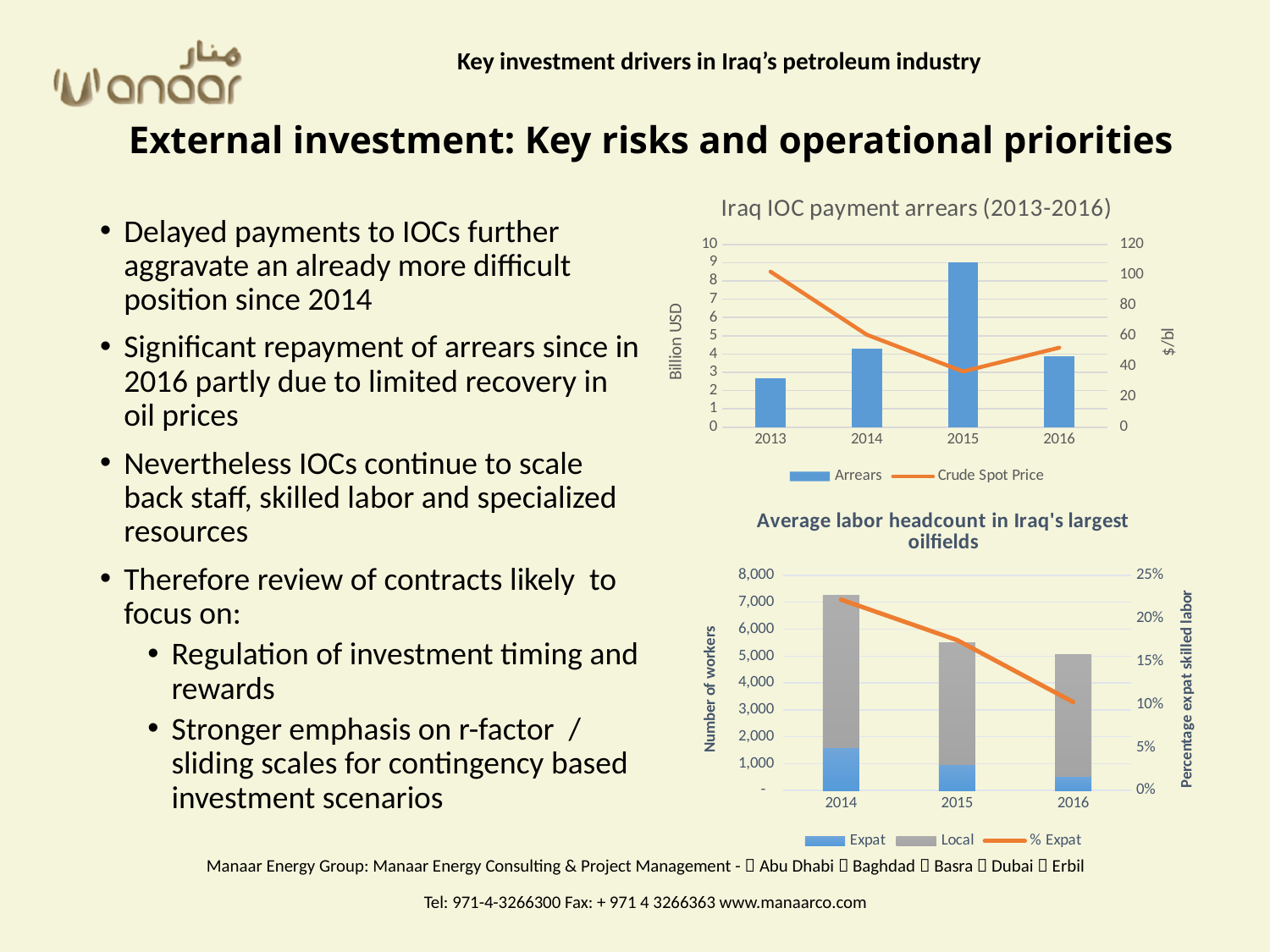
In the 'Iraq IOC payment arrears (2013-2016)' chart, is the crude spot price for 2013 greater or less than 80 $/bl? greater In the 'Iraq IOC payment arrears (2013-2016)' chart, how many years are shown on the x axis? 4 In the 'Average labor headcount in Iraq's largest oilfields' chart, which is larger, the Expat headcount in 2014 or in 2016? 2014 In the 'Average labor headcount in Iraq's largest oilfields' chart, what series does the grey colour represent? Local In the 'Iraq IOC payment arrears (2013-2016)' chart, which year has the lowest arrears bar? 2013 In the 'Average labor headcount in Iraq's largest oilfields' chart, which year has the highest total headcount? 2014 In the 'Average labor headcount in Iraq's largest oilfields' chart, is the % Expat value for 2014 greater or less than 20%? greater In the 'Iraq IOC payment arrears (2013-2016)' chart, which year has the highest arrears bar? 2015 In the 'Iraq IOC payment arrears (2013-2016)' chart, how many series does the legend list? 2 In the 'Average labor headcount in Iraq's largest oilfields' chart, does the % Expat line rise or fall from 2014 to 2016? fall In the 'Iraq IOC payment arrears (2013-2016)' chart, which year has the lowest crude spot price? 2015 In the 'Iraq IOC payment arrears (2013-2016)' chart, is the arrears value for 2015 greater or less than 8 billion USD? greater